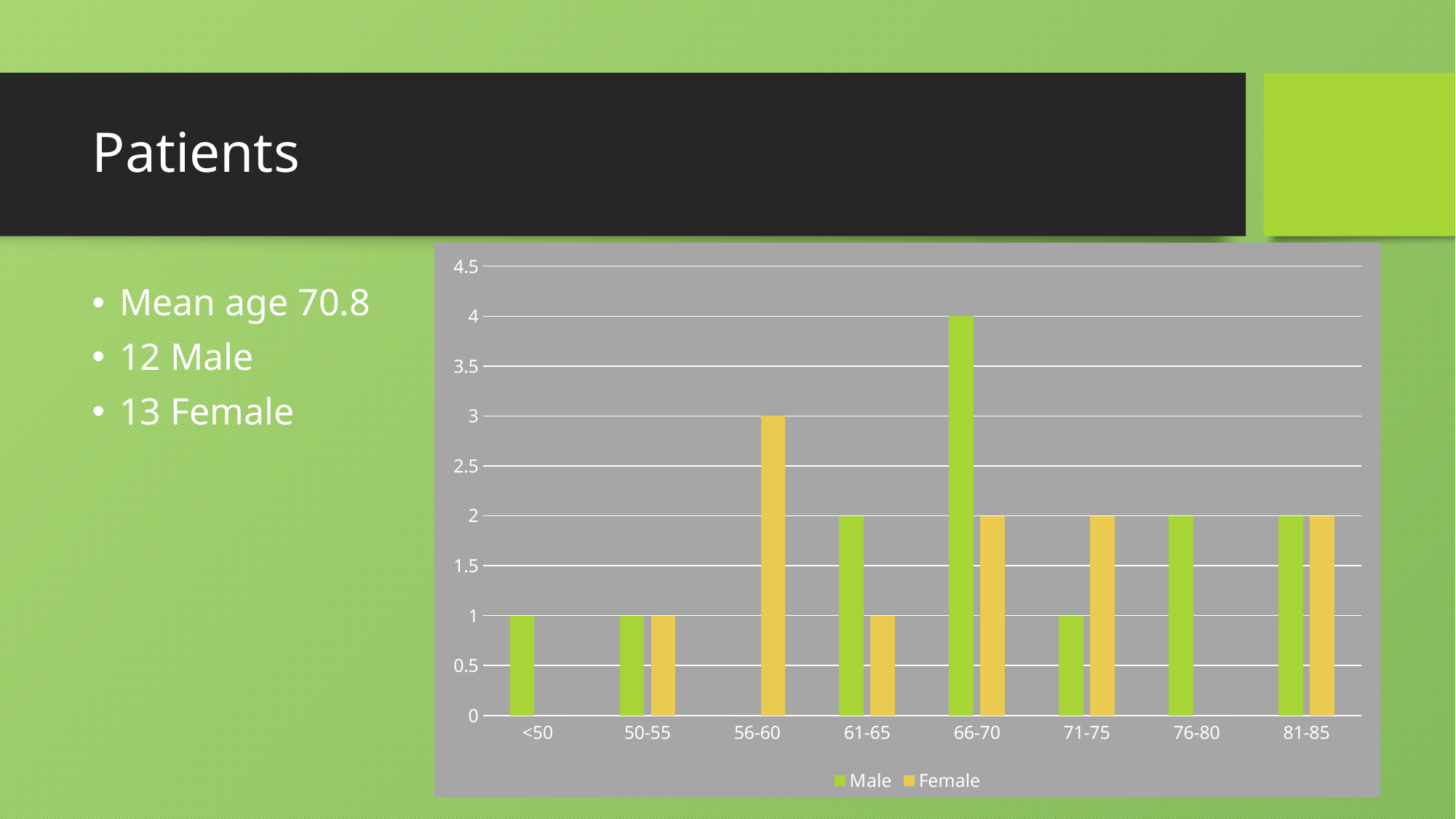
Which age group has the highest Male value? 66-70 What is the Male value for the 66-70 age group? 4 How many series does the legend list? 2 What is the difference between the Male and Female values in the 66-70 age group? 2 Which colour represents the Female series in the legend? Yellow/gold Is the Male value for the 66-70 age group greater or less than 3? greater Which age group has the highest Female value? 56-60 How many age-group categories are shown on the x axis? 8 What is the Female value for the 71-75 age group? 2 What kind of chart is shown on the slide? Bar chart What is the Female value for the 56-60 age group? 3 In the 61-65 age group, which is larger, the Male value or the Female value? Male